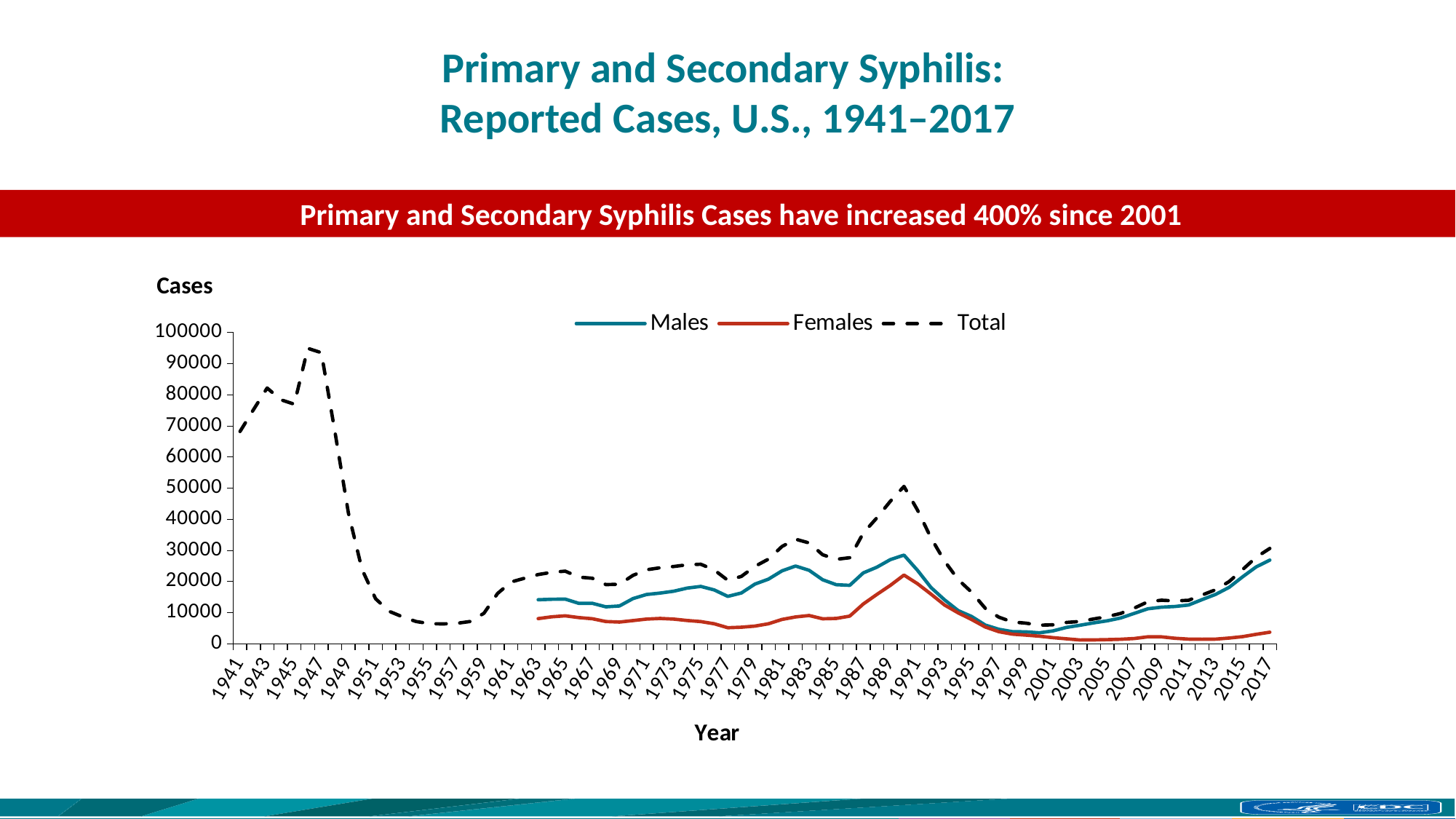
In which year does the Females series reach its highest value? 1990 In 1991, which series has the larger value, Males or Females? Males In which year does the Total series reach its highest value? 1946 Is the Males value for 2017 greater or less than 20000? greater How many series does the legend list? 3 Which is larger, the Total value in 1947 or the Total value in 1991? 1947 What kind of chart is shown on the slide? Line chart Is the Females value for 2001 greater or less than 10000? less Which series is drawn with a dashed line? Total Is the Total value for 1957 greater or less than 10000? less Does the Total series rise or fall from 2001 to 2017? Rise